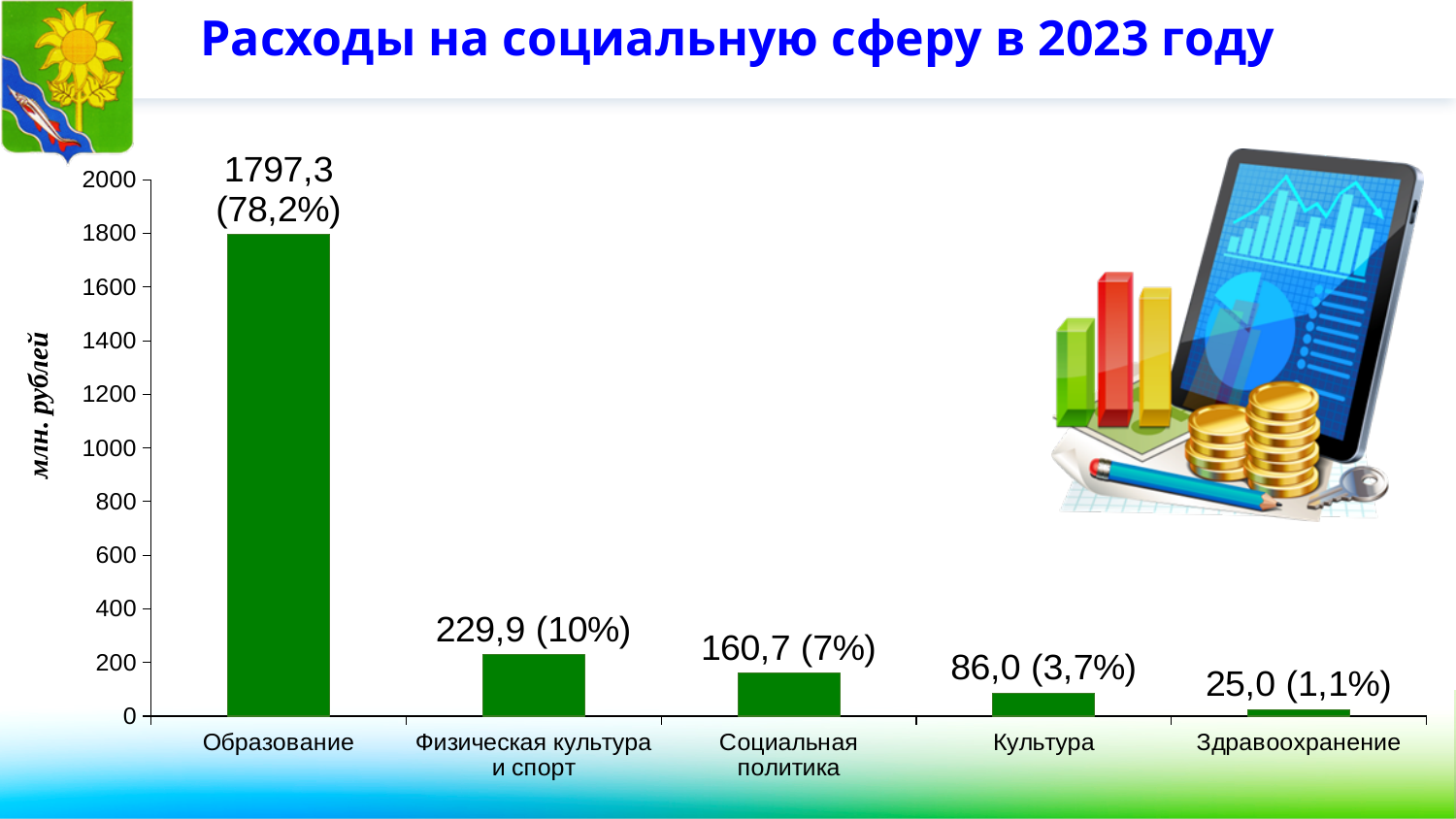
Какая категория имеет наименьшие расходы? Здравоохранение Что больше: расходы на социальную политику или на культуру? Социальная политика На сколько расходы на культуру больше расходов на здравоохранение? 61,0 Сколько категорий расходов показано на диаграмме? 5 Какое значение указано для категории «Социальная политика»? 160,7 Какое значение расходов на образование показано на диаграмме? 1797,3 Какая доля расходов приходится на физическую культуру и спорт? 10% Какая доля расходов приходится на здравоохранение? 1,1% На сколько расходы на образование больше расходов на физическую культуру и спорт? 1567,4 В каких единицах измерения указаны значения на вертикальной оси? млн. рублей Какая категория имеет наибольшие расходы? Образование Какой тип диаграммы показан на слайде? Столбчатая (bar chart)